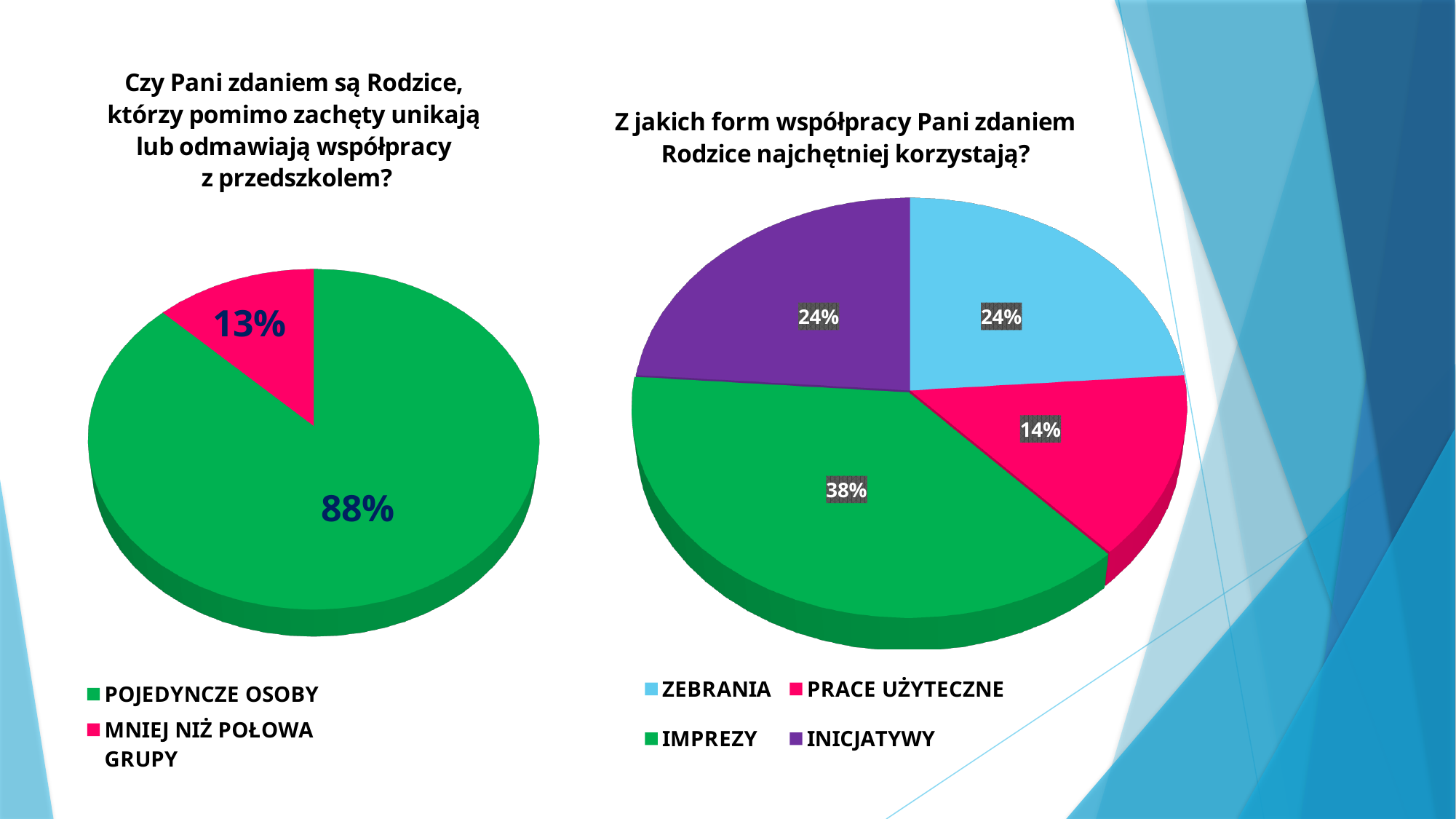
What kind of chart is the left chart ("Czy Pani zdaniem są Rodzice...")? Pie chart In the right chart ("Z jakich form współpracy..."), what share is labelled for ZEBRANIA? 24% In the right chart ("Z jakich form współpracy..."), what share is labelled for IMPREZY? 38% In the right chart ("Z jakich form współpracy..."), how many categories does the legend list? 4 In the left chart ("Czy Pani zdaniem są Rodzice..."), which category has the largest slice? POJEDYNCZE OSOBY In the left chart ("Czy Pani zdaniem są Rodzice..."), what share is labelled for MNIEJ NIŻ POŁOWA GRUPY? 13% In the right chart ("Z jakich form współpracy..."), what share is labelled for PRACE UŻYTECZNE? 14% In the left chart ("Czy Pani zdaniem są Rodzice..."), how many categories does the legend list? 2 In the right chart ("Z jakich form współpracy..."), which category has the smallest slice? PRACE UŻYTECZNE In the right chart ("Z jakich form współpracy..."), what is the difference in percentage points between IMPREZY and PRACE UŻYTECZNE? 24 In the right chart ("Z jakich form współpracy..."), which category has the largest slice? IMPREZY In the left chart ("Czy Pani zdaniem są Rodzice..."), what share is labelled for POJEDYNCZE OSOBY? 88%